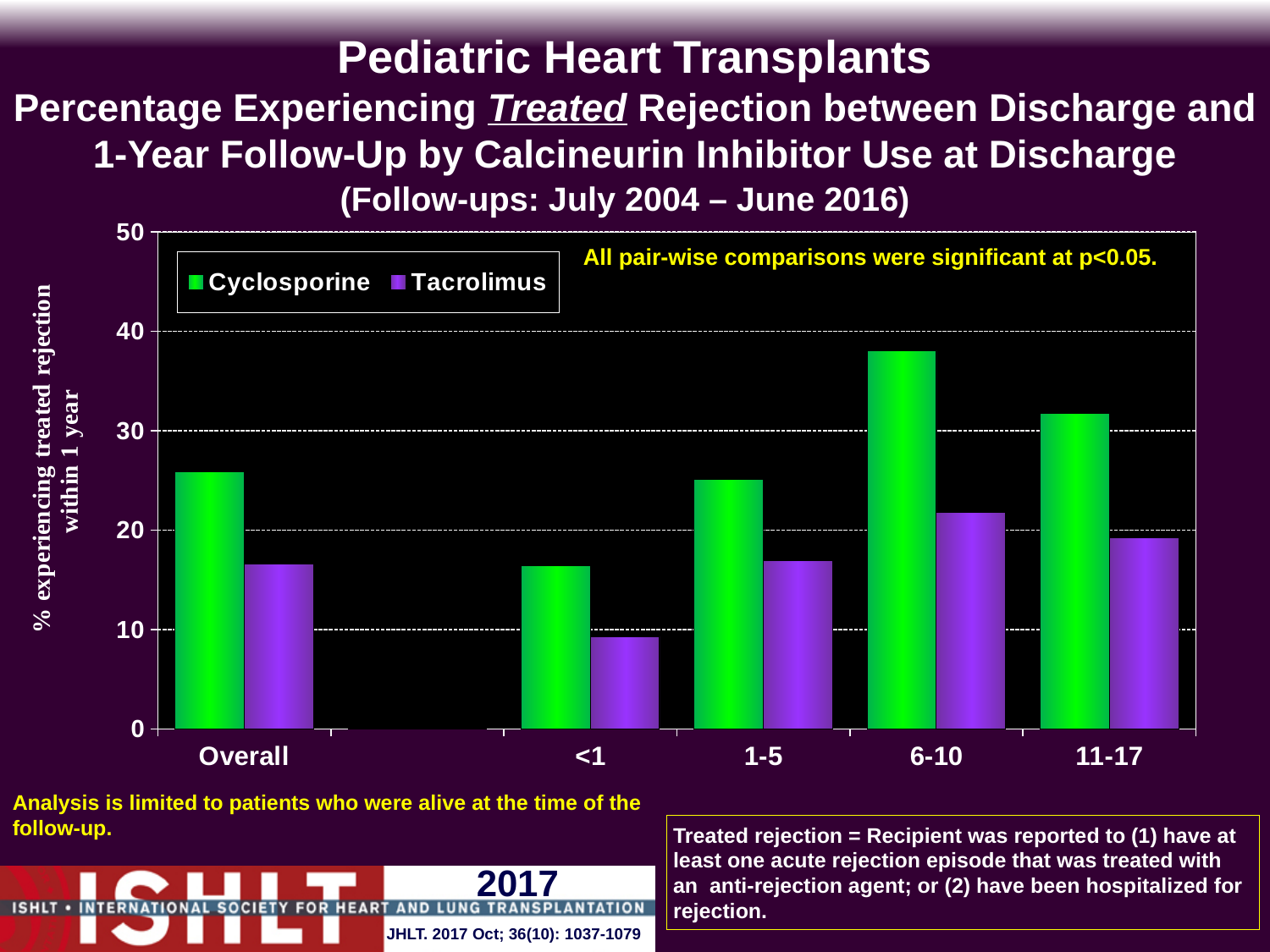
Which category has the highest Cyclosporine value? 6-10 Is the Cyclosporine value for 6-10 greater or less than 30? greater Which category has the highest Tacrolimus value? 6-10 In the 1-5 category, which is larger, the Cyclosporine value or the Tacrolimus value? Cyclosporine What kind of chart is shown on the slide? bar chart How many age categories are shown along the x axis? 4 Is the Tacrolimus value for <1 greater or less than 10? less Which category has the lowest Tacrolimus value? <1 Which category has the lowest Cyclosporine value? <1 How many series does the legend list? 2 What colour represents Tacrolimus in the legend? purple Is the Cyclosporine value for Overall greater or less than 20? greater